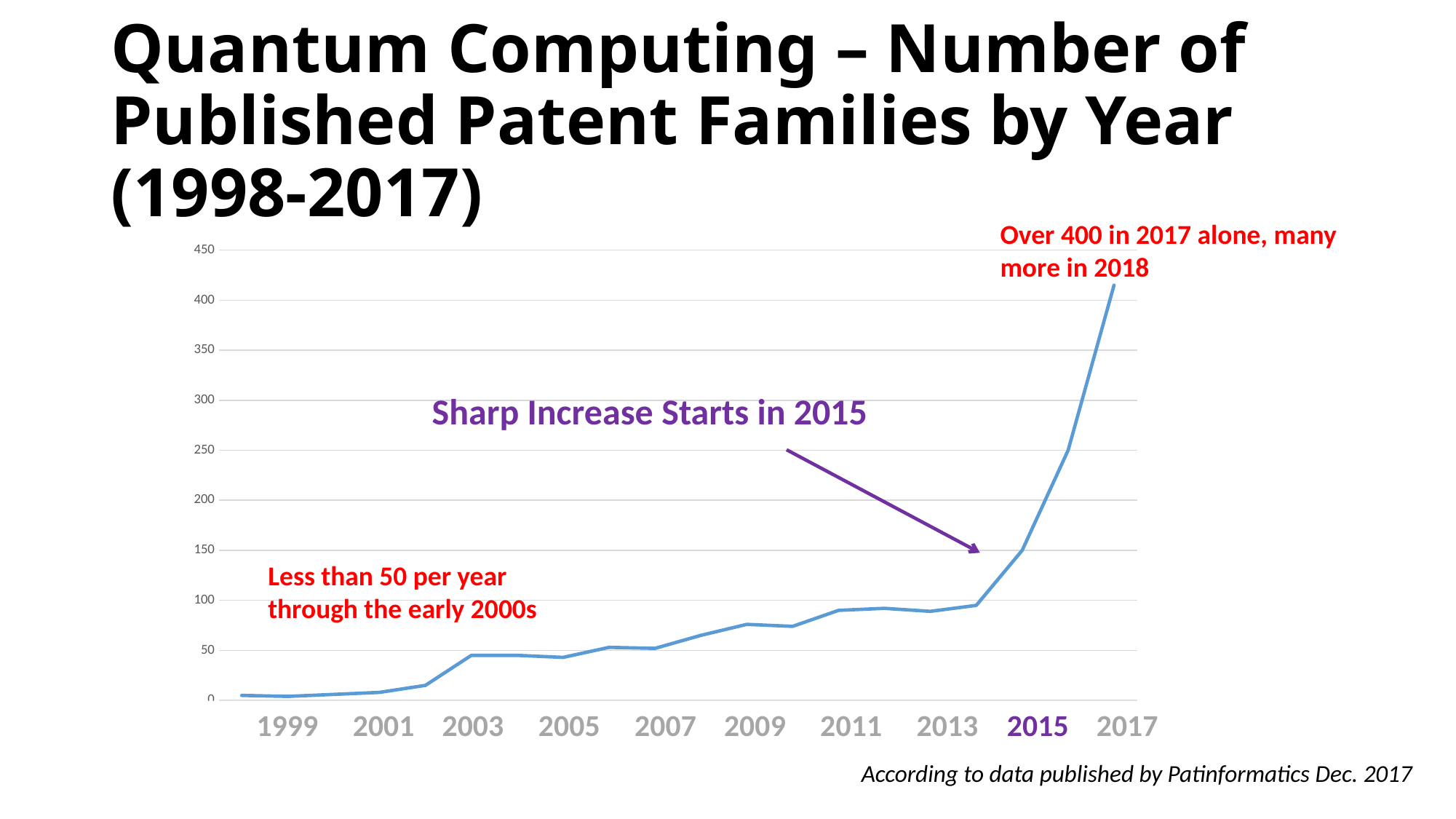
Is the value for 2016 greater or less than 200? greater Do the values generally rise or fall from 1999 to 2017? rise Is the value for 2017 greater or less than 400? greater What kind of chart is shown on the slide? line chart Which year has the highest number of published patent families? 2017 Is the value for 2003 greater or less than 50? less Which year has the larger value, 2015 or 2017? 2017 How many year labels are shown on the x axis? 10 According to the annotation on the chart, in which year does the sharp increase start? 2015